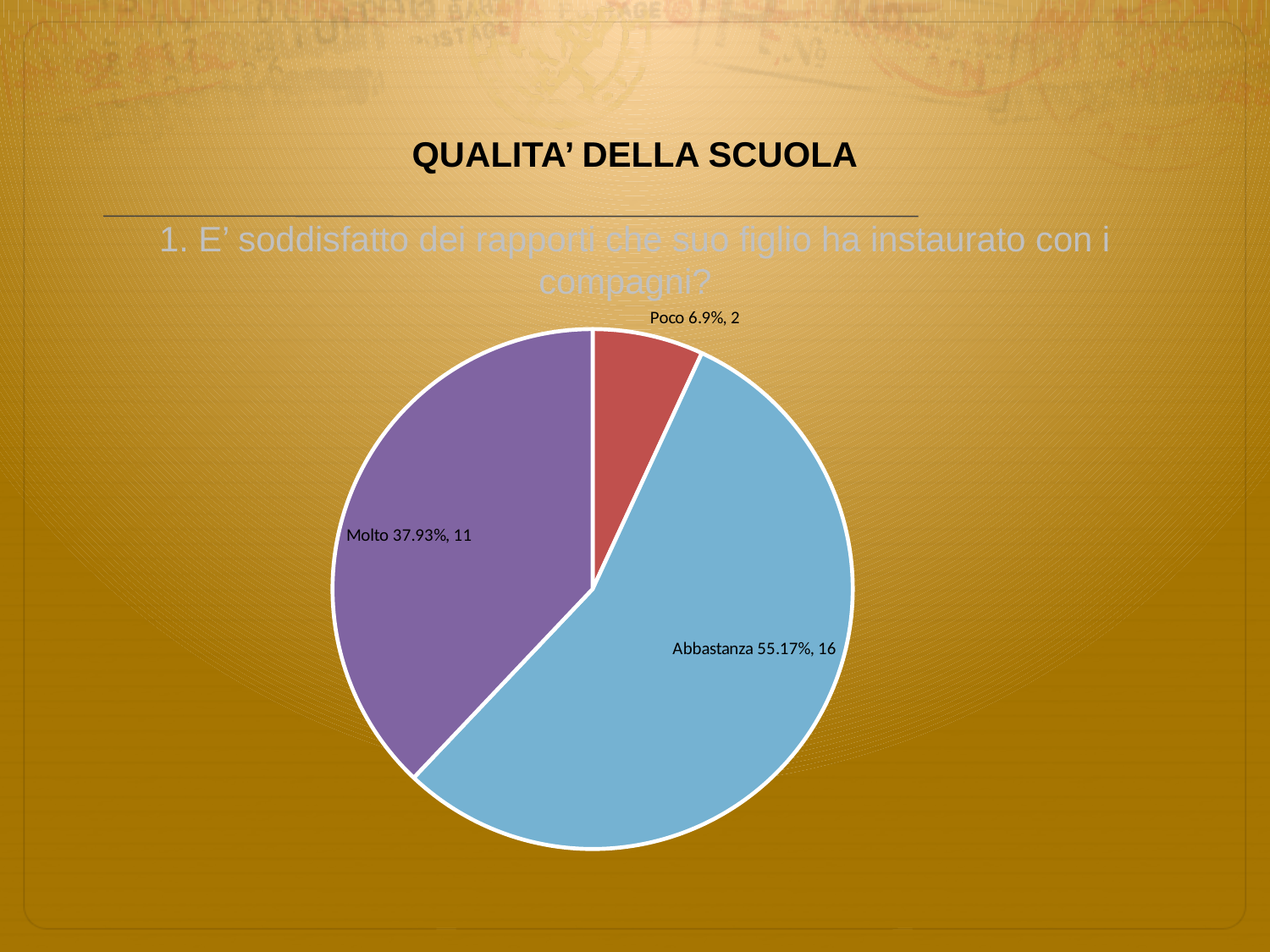
What percentage share does the Poco slice have? 6.9% Which is larger, the Molto slice or the Poco slice? Molto What is the difference in count between Abbastanza and Molto? 5 What percentage share does the Abbastanza slice have? 55.17% What percentage share does the Molto slice have? 37.93% What is the count shown for Abbastanza? 16 What kind of chart is shown on the slide? pie chart How many slices does the pie chart have? 3 What is the count shown for Poco? 2 What is the count shown for Molto? 11 Which category has the smallest slice? Poco Which category has the largest slice? Abbastanza